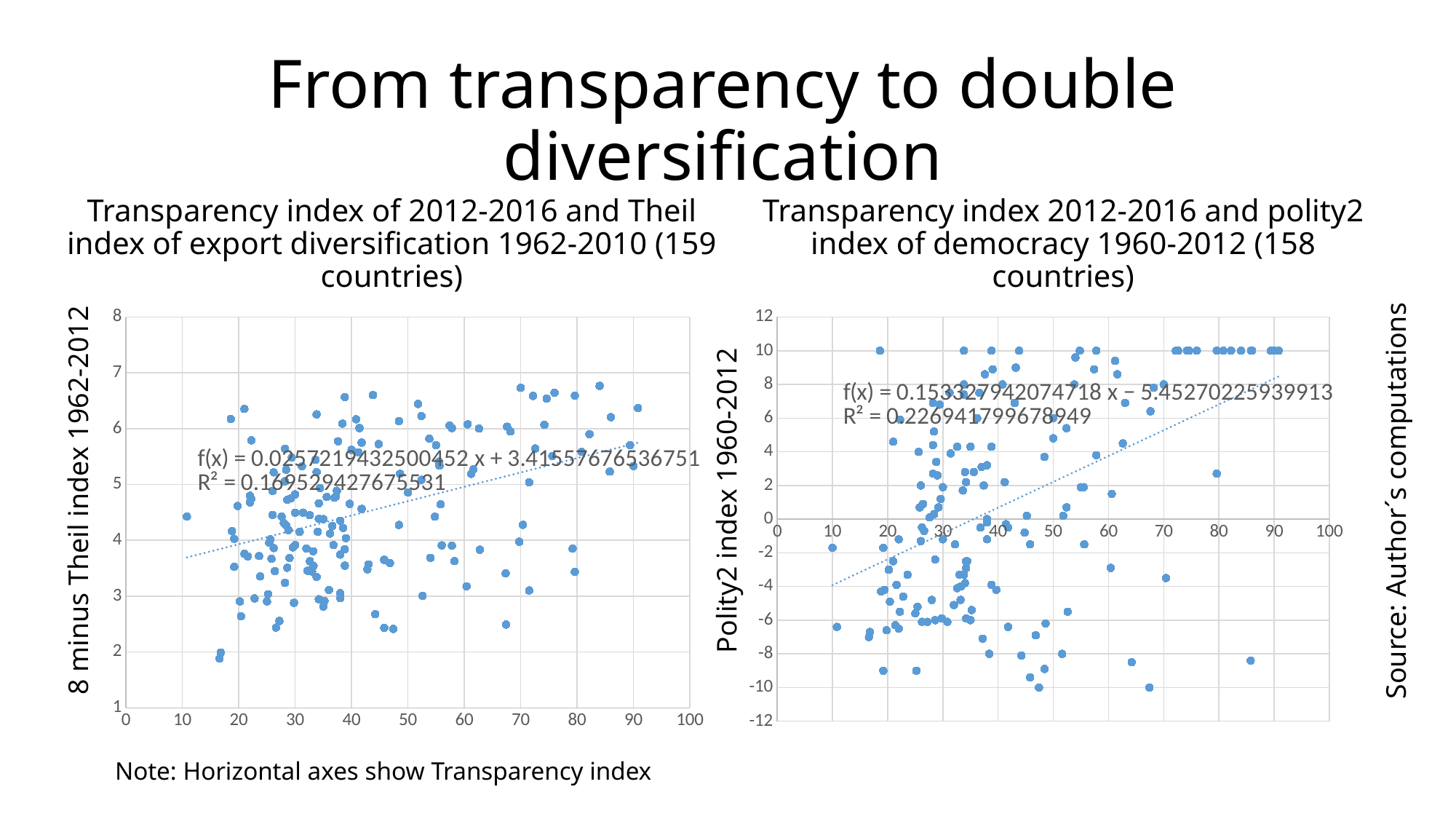
In the right chart, is the highest Polity2 index value plotted greater or less than 8? greater In the left chart, is the highest '8 minus Theil index' value plotted greater or less than 7? less What is the R² value shown on the right chart (polity2 index of democracy)? 0.226941799678949 In the left chart (Theil index of export diversification), does the fitted trend line rise or fall as the Transparency index increases? Rises What is the slope of the fitted line shown on the right chart (polity2 index of democracy)? 0.153327942074718 What kind of chart is the left chart, titled 'Transparency index of 2012-2016 and Theil index of export diversification 1962-2010 (159 countries)'? Scatter plot In the right chart (polity2 index of democracy), does the fitted trend line rise or fall as the Transparency index increases? Rises What is the intercept of the fitted line shown on the left chart (Theil index of export diversification)? 3.41557676536751 What is the vertical axis label of the right chart? Polity2 index 1960-2012 What kind of chart is the right chart, titled 'Transparency index 2012-2016 and polity2 index of democracy 1960-2012 (158 countries)'? Scatter plot How many countries are plotted in the right chart, according to its title? 158 countries How many countries are plotted in the left chart, according to its title? 159 countries